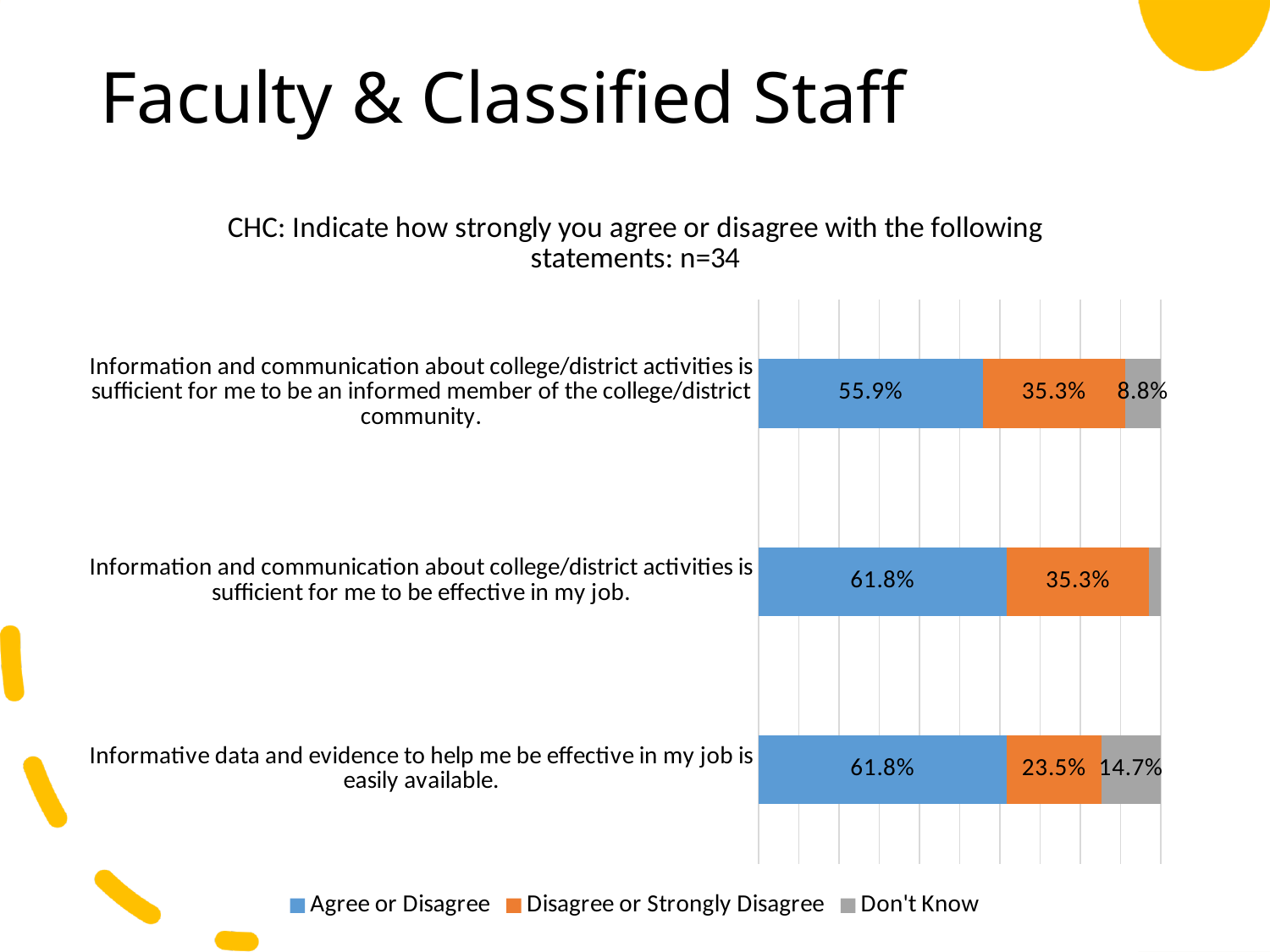
Which statement has the highest 'Don't Know' value? Informative data and evidence to help me be effective in my job is easily available. What is the 'Agree or Disagree' value for the statement 'Information and communication about college/district activities is sufficient for me to be effective in my job.'? 61.8% What is the 'Don't Know' value for the statement 'Informative data and evidence to help me be effective in my job is easily available.'? 14.7% What is the title of the chart? CHC: Indicate how strongly you agree or disagree with the following statements: n=34 What is the 'Disagree or Strongly Disagree' value for the statement 'Informative data and evidence to help me be effective in my job is easily available.'? 23.5% What is the difference between the 'Disagree or Strongly Disagree' value for the 'informed member of the college/district community' statement and the 'Informative data and evidence' statement? 11.8 percentage points How many statements (categories) are plotted in the chart? 3 How many series does the legend list? 3 Which statement has the lowest 'Agree or Disagree' value? Information and communication about college/district activities is sufficient for me to be an informed member of the college/district community. What kind of chart is shown on the slide? Stacked bar chart What is the 'Agree or Disagree' value for the statement 'Information and communication about college/district activities is sufficient for me to be an informed member of the college/district community.'? 55.9% Which is larger: the 'Agree or Disagree' value for the 'informed member of the college/district community' statement or for the 'Informative data and evidence' statement? Informative data and evidence to help me be effective in my job is easily available.